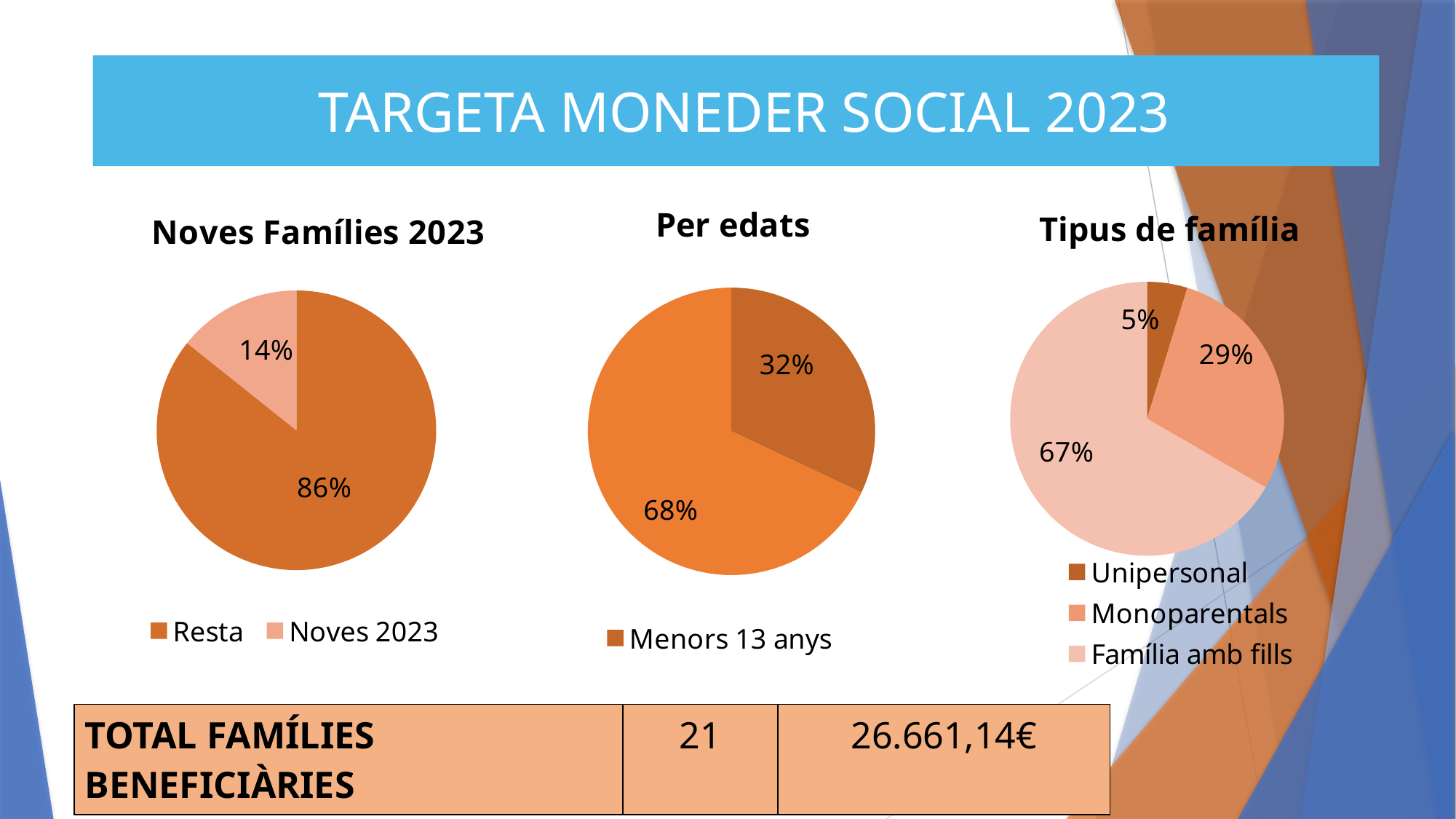
In the 'Tipus de família' chart, what share does 'Unipersonal' have? 5% In the 'Tipus de família' chart, what share does 'Monoparentals' have? 29% In the 'Per edats' chart, what share does 'Menors 13 anys' have? 32% In the 'Tipus de família' chart, which category has the largest share? Família amb fills What kind of chart is the 'Per edats' chart? Pie chart In the 'Per edats' chart, how many entries does the legend list? 1 In the 'Noves Famílies 2023' chart, what is the difference between the 'Resta' and 'Noves 2023' shares? 72% In the 'Noves Famílies 2023' chart, which slice is larger, 'Resta' or 'Noves 2023'? Resta In the 'Tipus de família' chart, how many categories are shown? 3 In the 'Tipus de família' chart, which category has the smallest share? Unipersonal